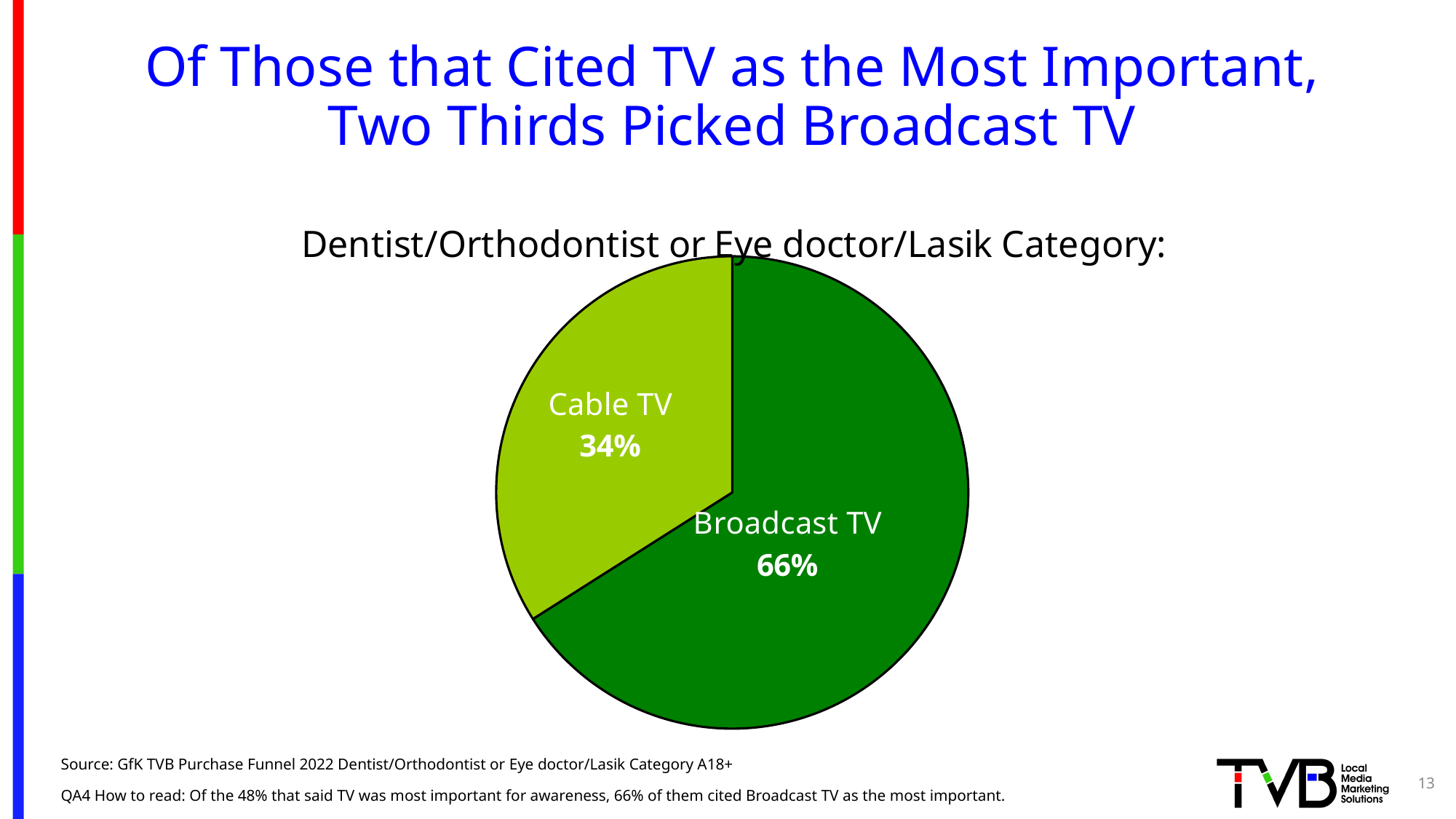
Which is larger, the Cable TV slice or the Broadcast TV slice? Broadcast TV What is the difference in percentage points between Broadcast TV and Cable TV? 32 What share of the pie does Broadcast TV represent? 66% How many slices does the pie chart have? 2 Which slice of the pie chart is the largest? Broadcast TV Which slice of the pie chart is the smallest? Cable TV What percentage of the pie chart is Cable TV? 34% Which slice of the pie chart is shown in the darker green colour? Broadcast TV What percentage of the pie chart is Broadcast TV? 66% What is the title of the pie chart? Dentist/Orthodontist or Eye doctor/Lasik Category: What kind of chart is shown on the slide? Pie chart